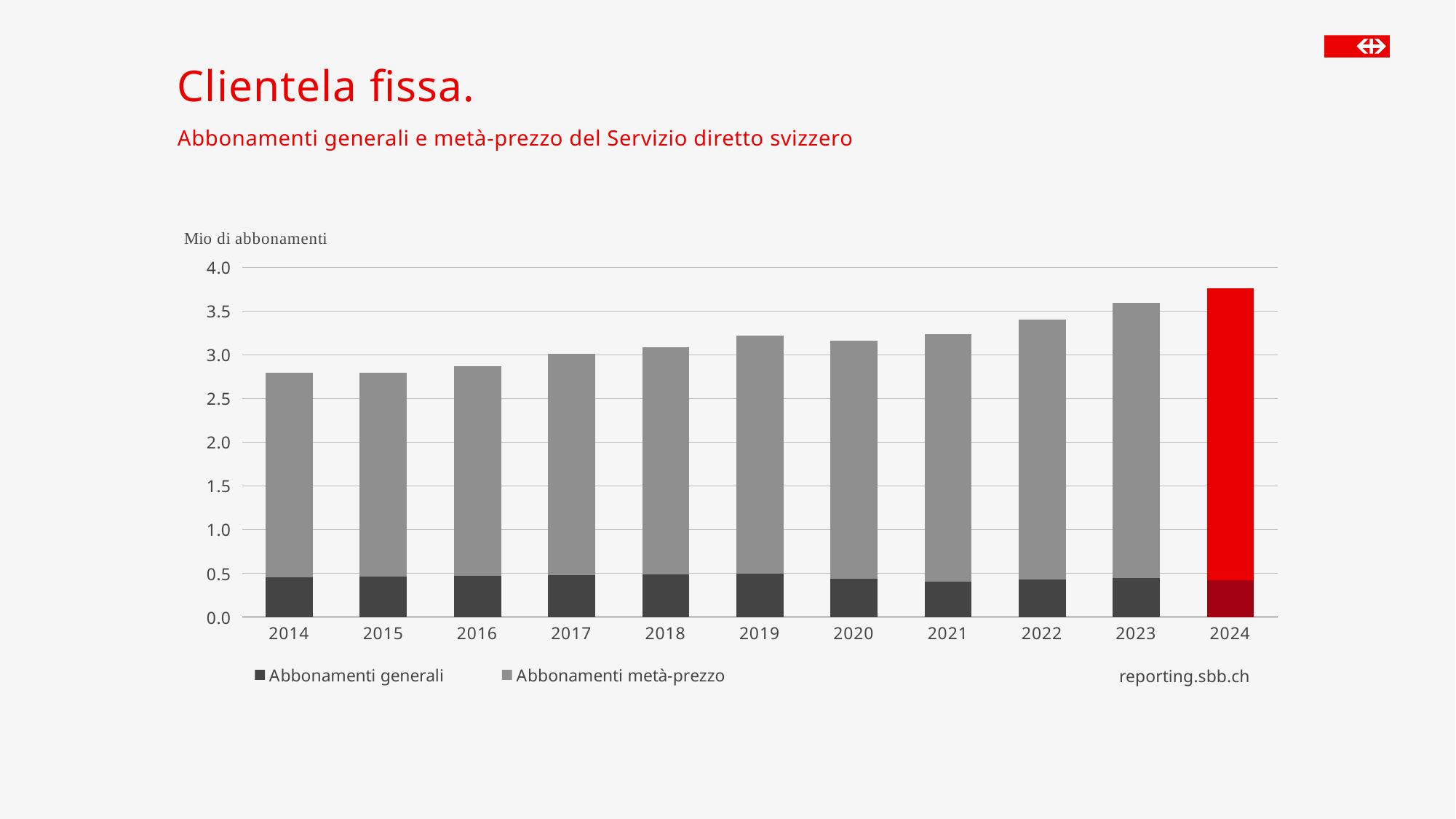
What kind of chart is shown on the slide? Stacked bar chart Is the total value for 2019 greater or less than 3.0? greater Is the total value for 2023 greater or less than 3.5? greater How many years are shown on the x axis of the chart? 11 How many series does the chart legend list? 2 Do the total values generally rise or fall from 2014 to 2024? rise What are the two series named in the chart legend? Abbonamenti generali and Abbonamenti metà-prezzo Is the total value for 2014 greater or less than 3.0? less Which year has the larger total, 2021 or 2022? 2022 What is the label on the y axis of the chart? Mio di abbonamenti Which year has the highest total number of subscriptions? 2024